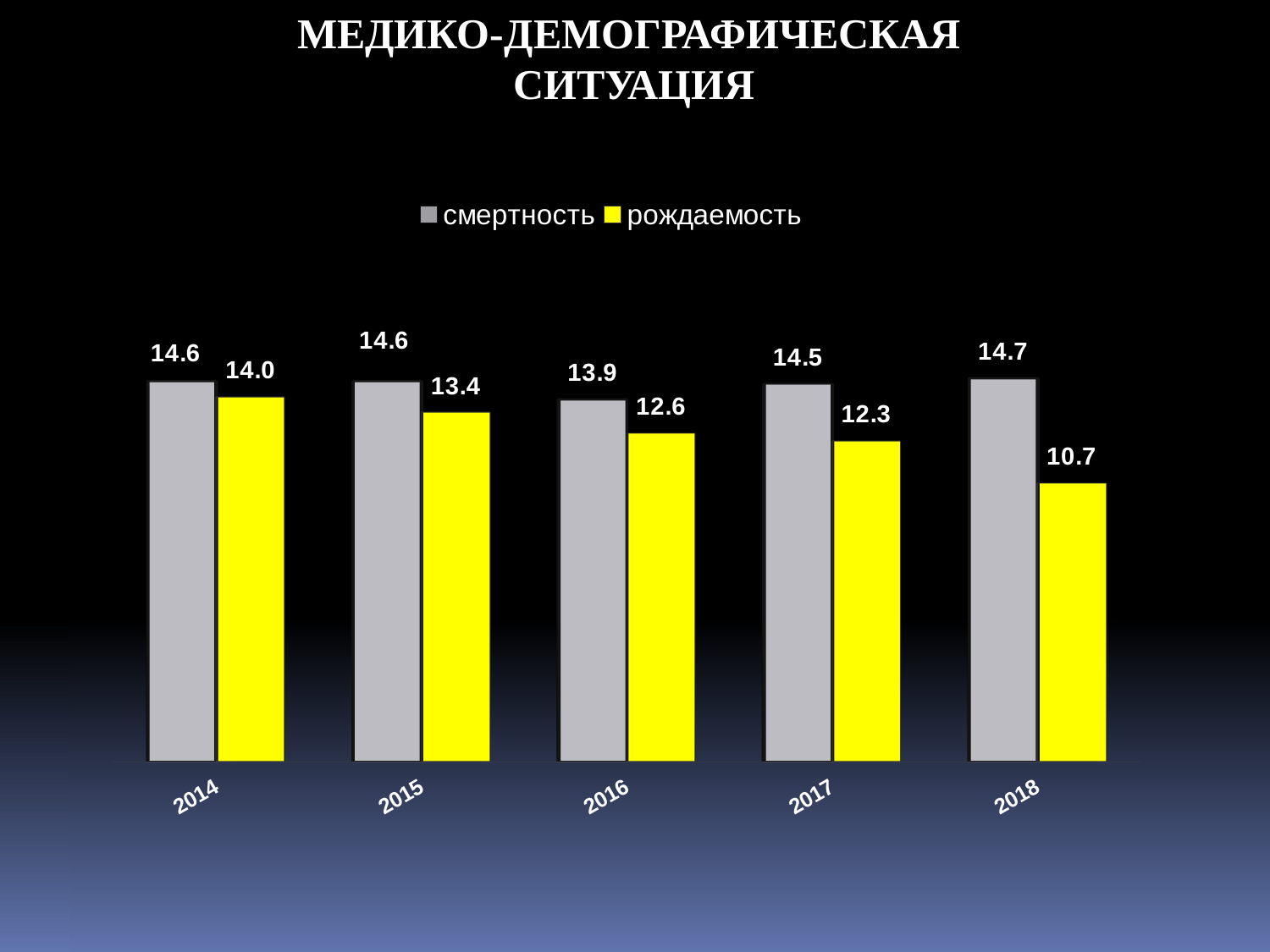
Does рождаемость rise or fall from 2014 to 2018? fall In which year is рождаемость highest? 2014 How many series does the legend list? 2 What is the difference between рождаемость in 2014 and in 2018? 3.3 What is the value for рождаемость in 2018? 10.7 Which is larger in 2017, смертность or рождаемость? смертность In which year is рождаемость lowest? 2018 What is the value for рождаемость in 2016? 12.6 In which year is смертность lowest? 2016 What is the difference between смертность and рождаемость in 2018? 4.0 What is the value for смертность in 2014? 14.6 How many years are shown on the x axis? 5